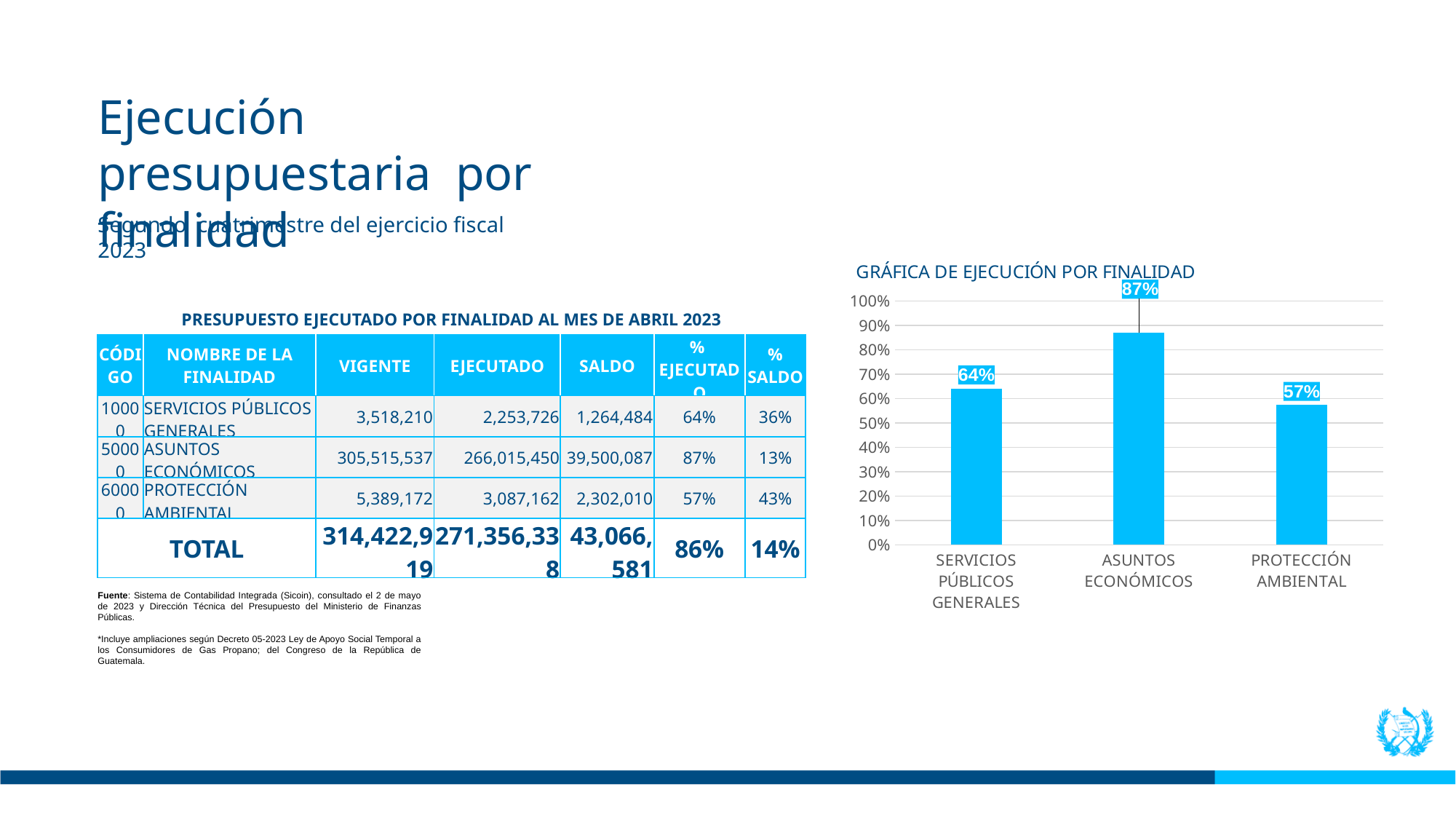
What is the title of the chart? GRÁFICA DE EJECUCIÓN POR FINALIDAD What kind of chart is shown on the slide? bar chart What is the difference between the values for SERVICIOS PÚBLICOS GENERALES and PROTECCIÓN AMBIENTAL? 7% Is the value for ASUNTOS ECONÓMICOS greater or less than 80%? greater Which category has the lowest value in the chart? PROTECCIÓN AMBIENTAL Which is larger, the value for SERVICIOS PÚBLICOS GENERALES or the value for PROTECCIÓN AMBIENTAL? SERVICIOS PÚBLICOS GENERALES Which category has the highest value in the chart? ASUNTOS ECONÓMICOS What is the value for ASUNTOS ECONÓMICOS in the chart? 87% What is the value for SERVICIOS PÚBLICOS GENERALES in the chart? 64% What is the difference between the values for ASUNTOS ECONÓMICOS and PROTECCIÓN AMBIENTAL? 30% How many categories are shown in the chart? 3 What is the value for PROTECCIÓN AMBIENTAL in the chart? 57%